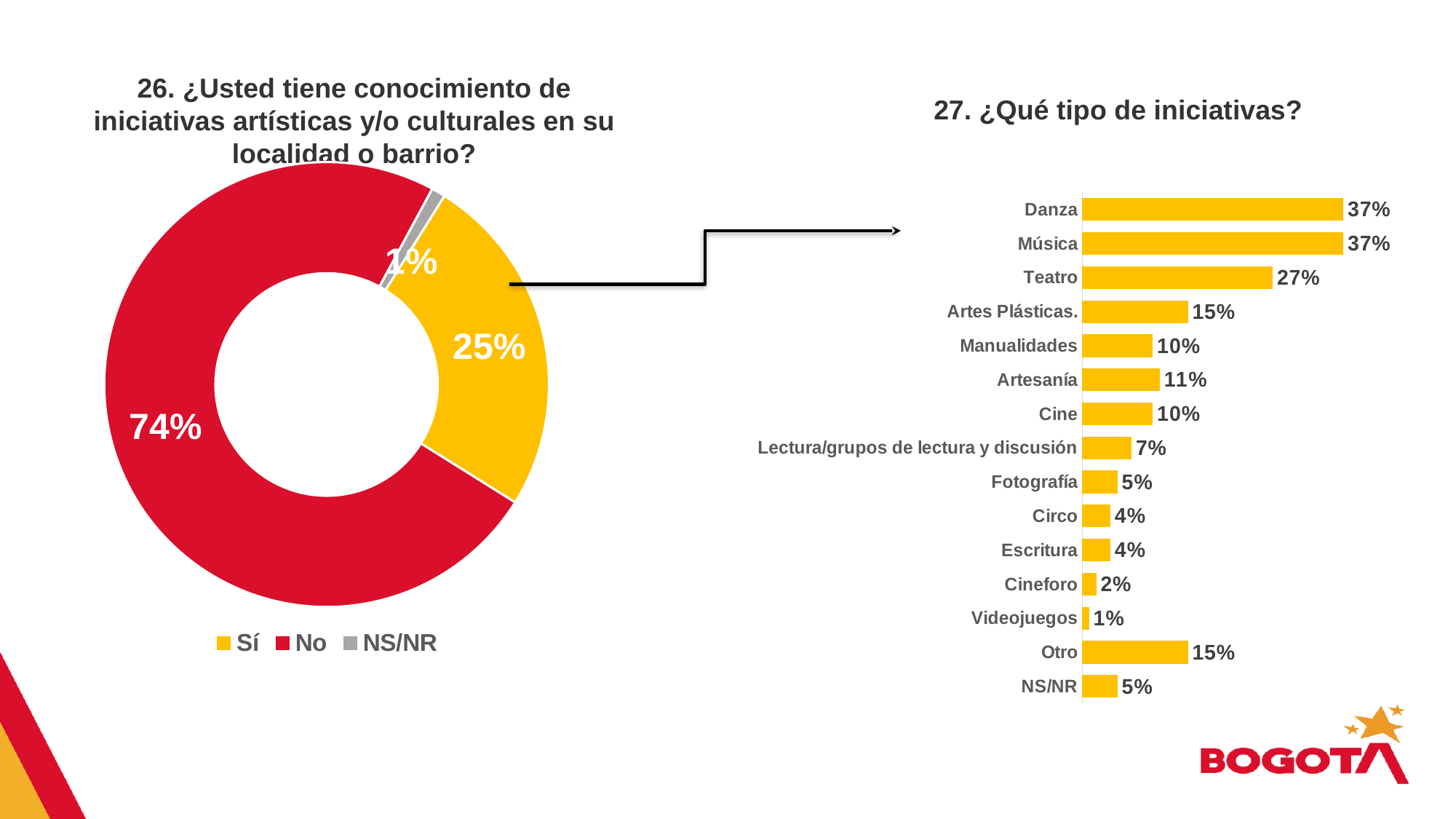
In the right chart (question 27), how many categories are shown? 15 In the right chart (question 27), what is the value for Artesanía? 11% In the right chart (question 27), what is the value for Teatro? 27% In the left chart (question 26), what percentage answered "No"? 74% What kind of chart is the left chart (question 26)? Doughnut chart In the right chart (question 27), what is the difference between Danza and Teatro? 10% What kind of chart is the right chart (question 27)? Bar chart In the left chart (question 26), what is the difference between the "No" and "Sí" shares? 49% In the left chart (question 26), how many entries does the legend list? 3 In the right chart (question 27), which category has the lowest value? Videojuegos In the left chart (question 26), what percentage answered "Sí"? 25% In the right chart (question 27), which is larger, Artes Plásticas. or Manualidades? Artes Plásticas.